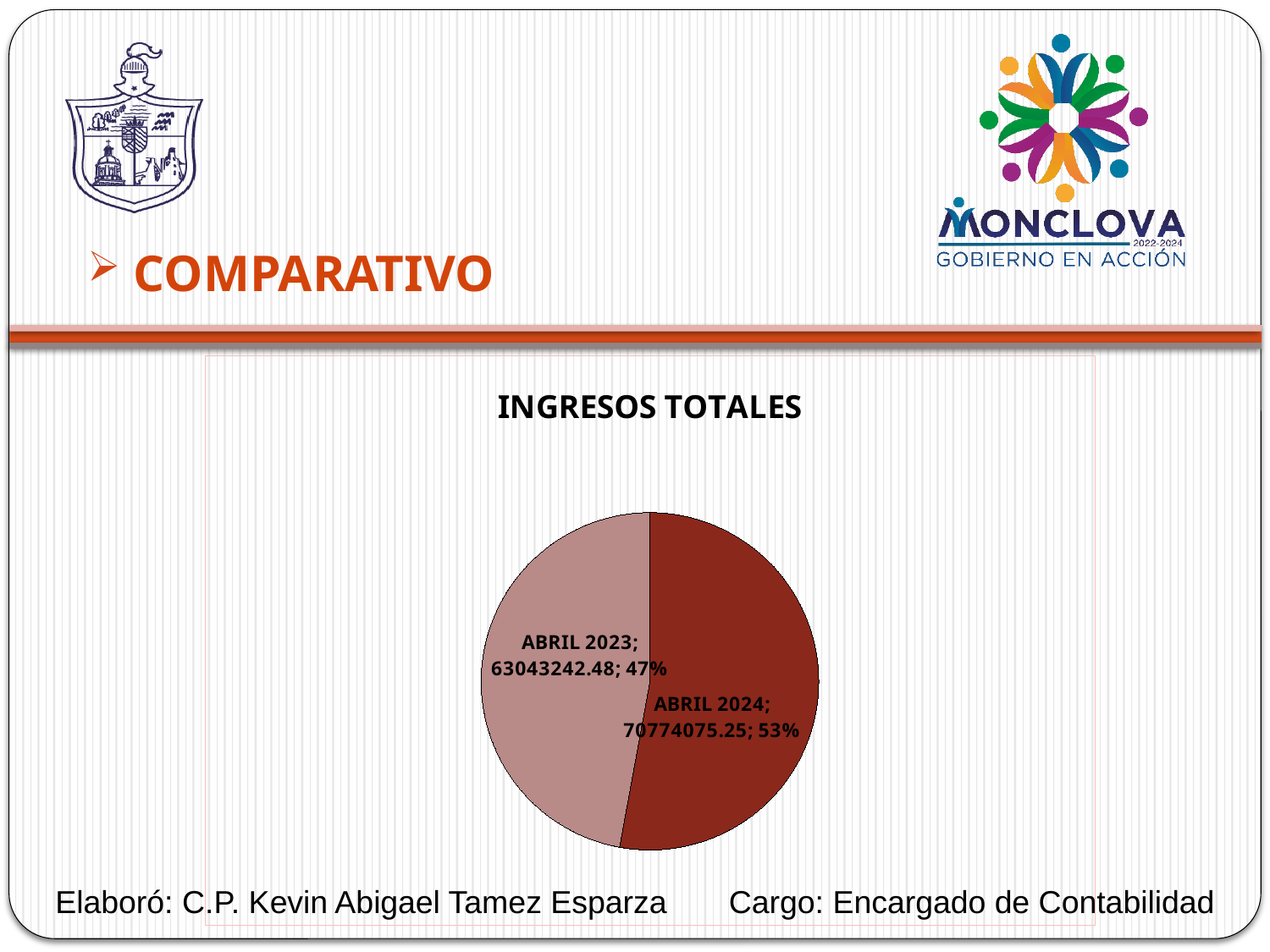
What share of the pie does ABRIL 2024 represent? 53% How many slices does the pie chart have? 2 What is the total of the two slices in the pie chart? 133817317.73 What kind of chart is shown on the slide? pie chart What is the value for ABRIL 2024? 70774075.25 What is the difference between the values for ABRIL 2024 and ABRIL 2023? 7730832.77 What is the value for ABRIL 2023? 63043242.48 Which slice is the smallest? ABRIL 2023 Which slice is the largest? ABRIL 2024 Which is larger, the value for ABRIL 2023 or ABRIL 2024? ABRIL 2024 What share of the pie does ABRIL 2023 represent? 47% What is the title of the chart? INGRESOS TOTALES